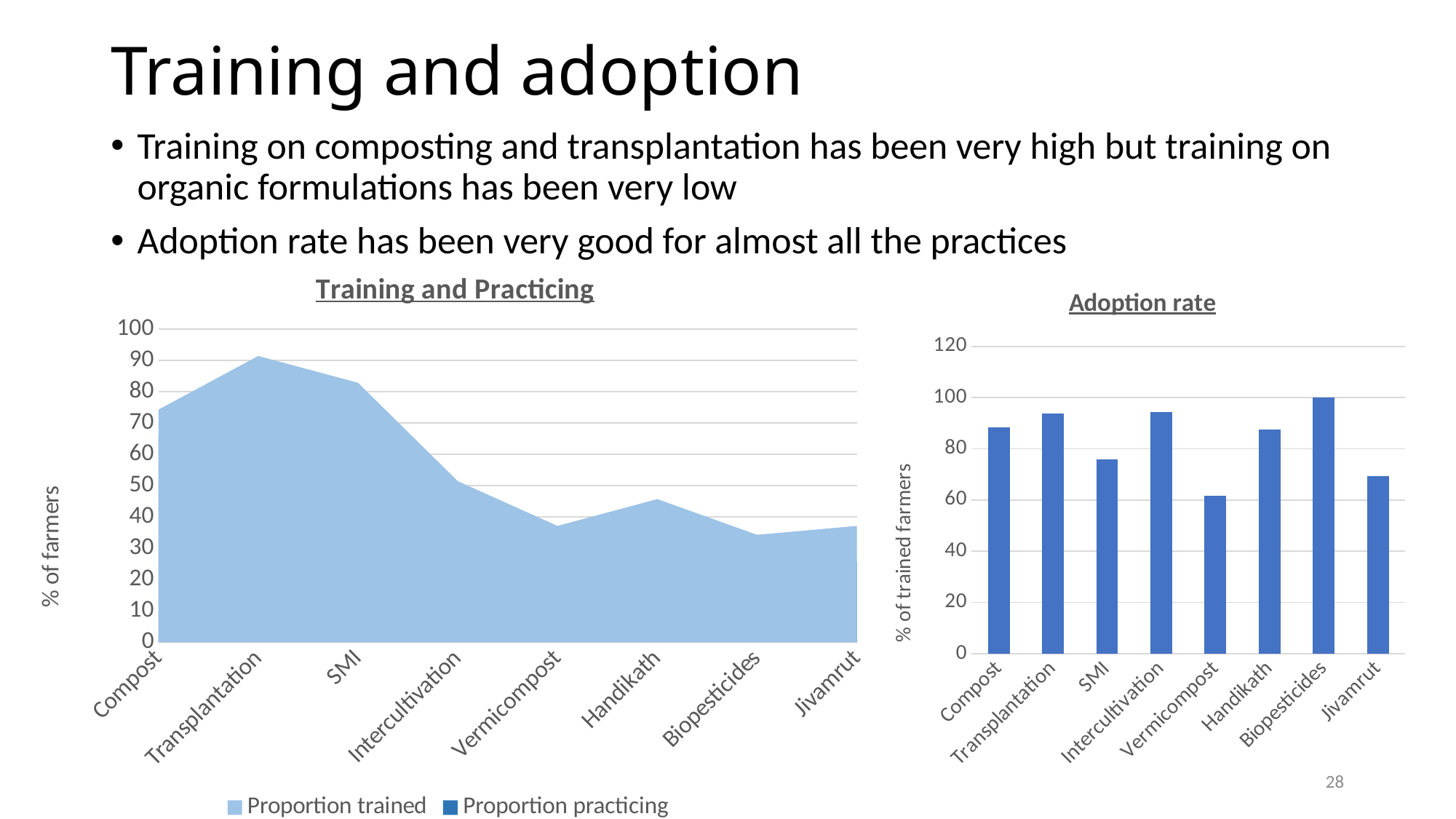
In the Training and Practicing chart, which is larger, the value for Compost or the value for Handikath? Compost How many categories are shown on the x axis of the Training and Practicing chart? 8 How many series does the legend of the Training and Practicing chart list? 2 In the Adoption rate chart, is the value for SMI greater or less than 80? less In the Adoption rate chart, which category has the highest value? Biopesticides What is the y-axis label of the Adoption rate chart? % of trained farmers In the Adoption rate chart, which category has the lowest value? Vermicompost In the Training and Practicing chart, is the value for Vermicompost greater or less than 40? less In the Training and Practicing chart, is the value for Transplantation greater or less than 80? greater What kind of chart is the Adoption rate chart? bar chart In the Training and Practicing chart, do the values rise or fall from Transplantation to Vermicompost? fall In the Training and Practicing chart, which category has the highest value? Transplantation